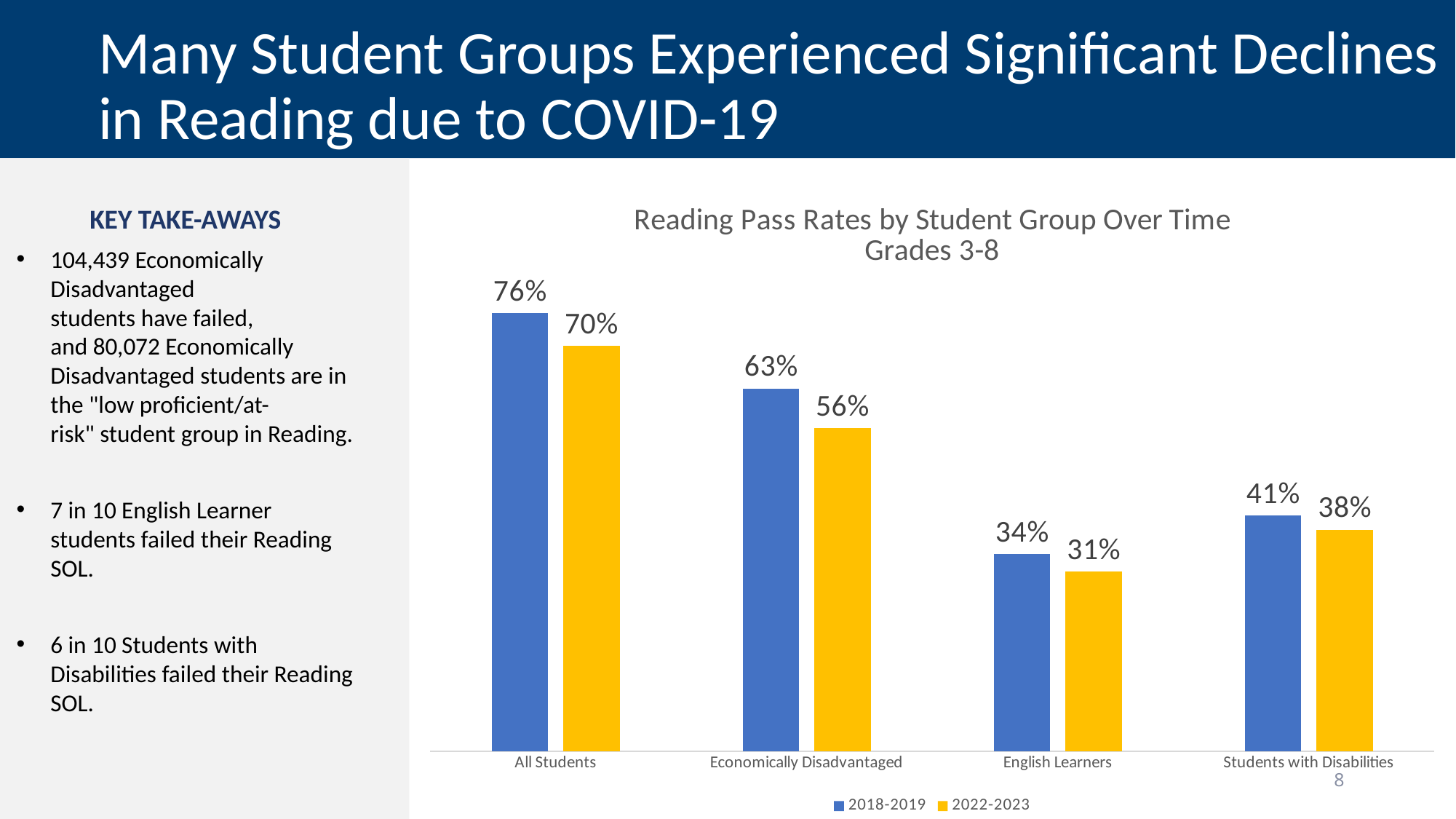
What was the reading pass rate for English Learners in 2022-2023? 31% What was the reading pass rate for All Students in 2018-2019? 76% How many student groups are shown on the x axis of the chart? 4 What was the reading pass rate for Students with Disabilities in 2018-2019? 41% Which student group had the highest reading pass rate in 2018-2019? All Students Which colour represents the 2022-2023 series in the chart? Yellow What type of chart is used to show reading pass rates by student group? Bar chart Which student group had the lowest reading pass rate in 2022-2023? English Learners By how many percentage points did the reading pass rate for Economically Disadvantaged students fall from 2018-2019 to 2022-2023? 7 How many series does the chart legend list? 2 Which is larger: the 2022-2023 pass rate for Economically Disadvantaged students or the 2022-2023 pass rate for Students with Disabilities? Economically Disadvantaged What is the title of the chart? Reading Pass Rates by Student Group Over Time Grades 3-8